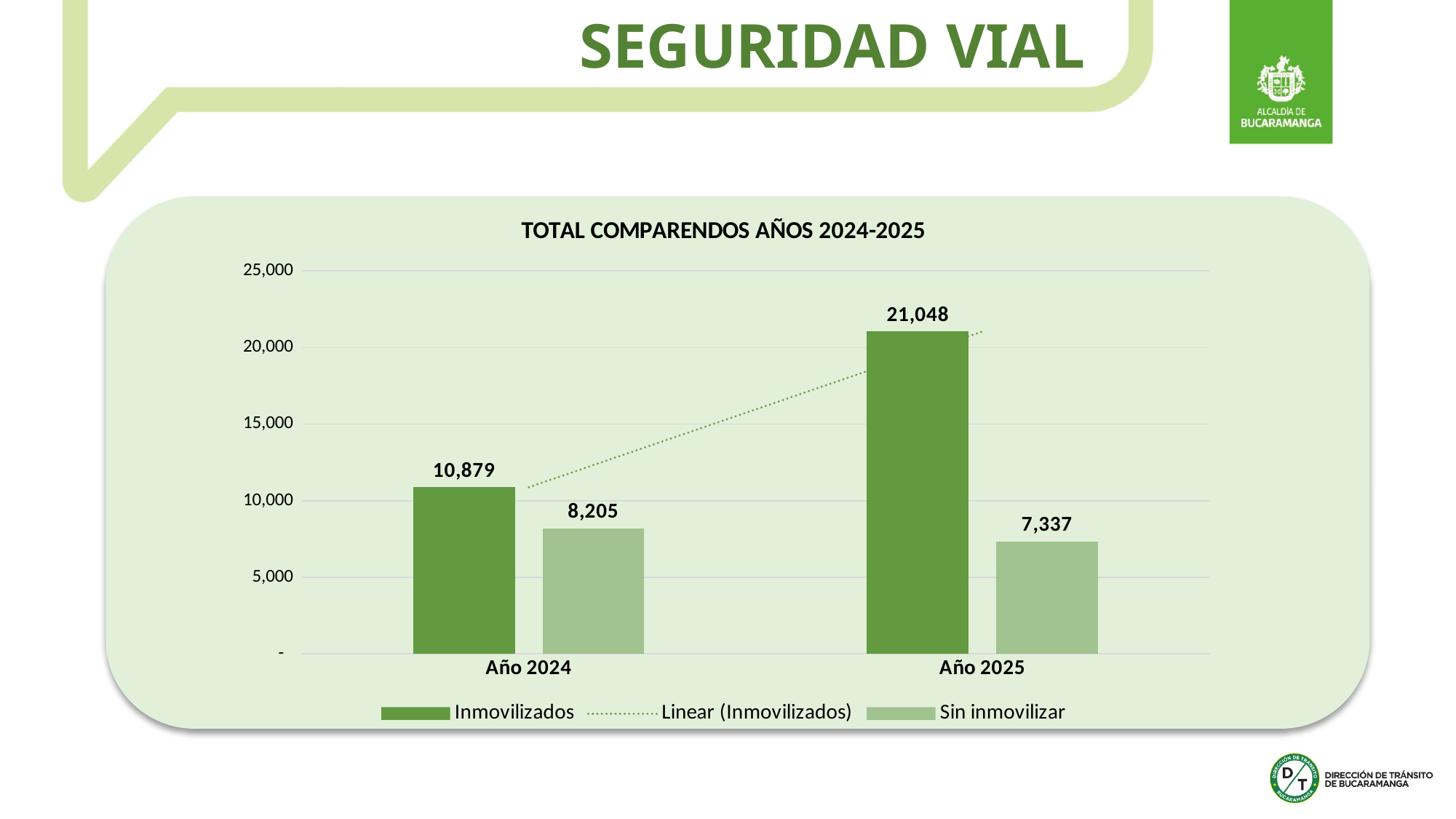
What is the difference between the Sin inmovilizar values for Año 2024 and Año 2025? 868 What is the value for Inmovilizados in Año 2024? 10,879 Which year has the lowest value for Sin inmovilizar? Año 2025 Which year has the highest value for Inmovilizados? Año 2025 What is the value for Sin inmovilizar in Año 2025? 7,337 How many entries does the legend list? 3 What is the difference between the Inmovilizados values for Año 2025 and Año 2024? 10,169 What is the value for Inmovilizados in Año 2025? 21,048 What is the value for Sin inmovilizar in Año 2024? 8,205 How many years are shown on the x axis? 2 Which is larger in Año 2024: Inmovilizados or Sin inmovilizar? Inmovilizados What kind of chart is shown on the slide? Bar chart